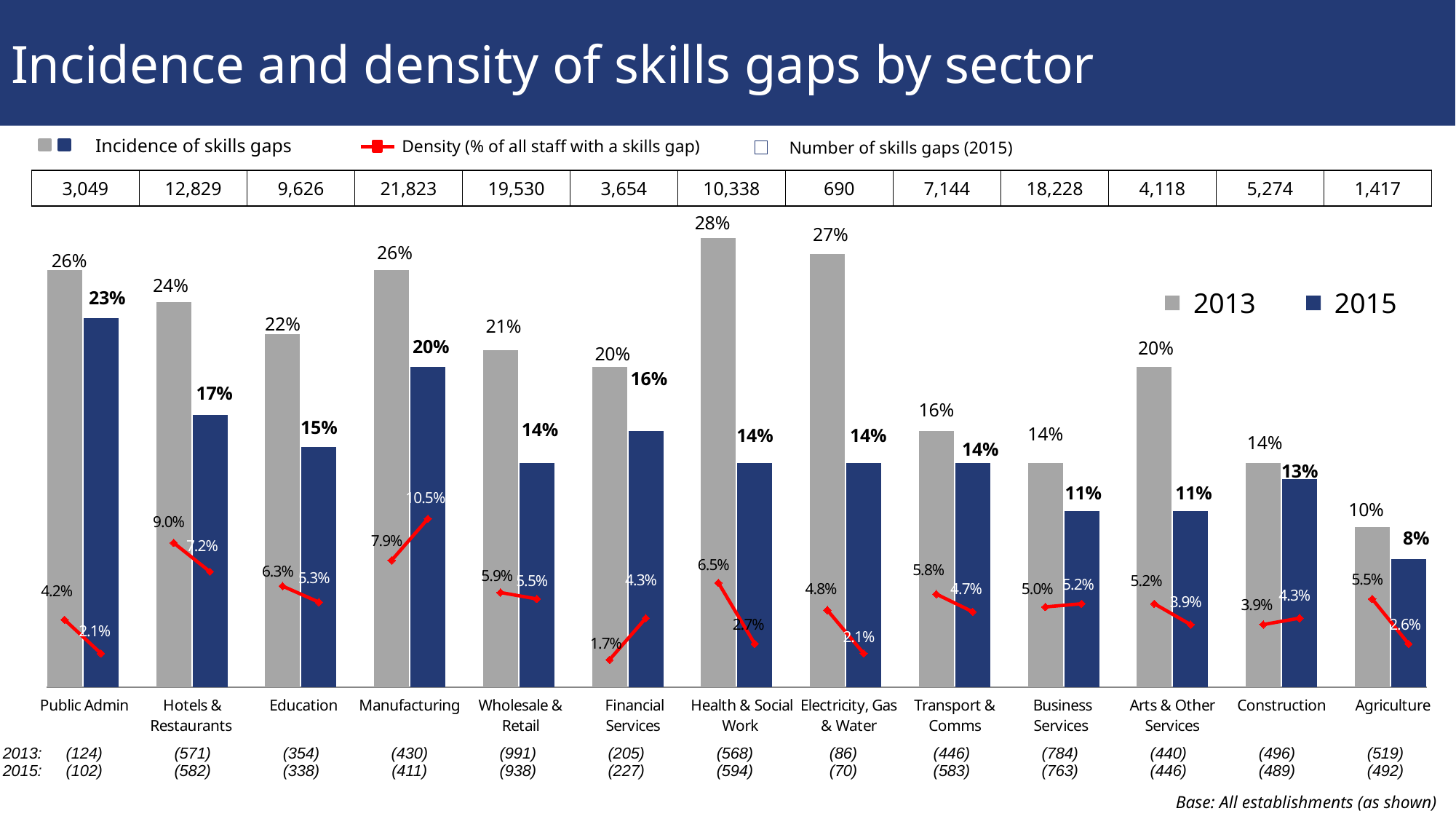
Which sector has the lowest 2013 density of skills gaps? Financial Services What is the 2015 density (% of all staff with a skills gap) for Manufacturing? 10.5% Which is larger, the 2015 incidence of skills gaps for Financial Services or for Education? Financial Services Which sector has the highest 2013 incidence of skills gaps? Health & Social Work What is the number of skills gaps (2015) shown for Wholesale & Retail? 19,530 What kind of chart is used to show the incidence of skills gaps? Bar chart What is the 2013 incidence of skills gaps for Manufacturing? 26% How many sectors are shown on the chart? 13 What is the difference between the 2013 and 2015 incidence of skills gaps for Health & Social Work? 14 percentage points How many years does the bar legend list? 2 Which sector has the lowest 2015 incidence of skills gaps? Agriculture What is the 2015 incidence of skills gaps for Public Admin? 23%